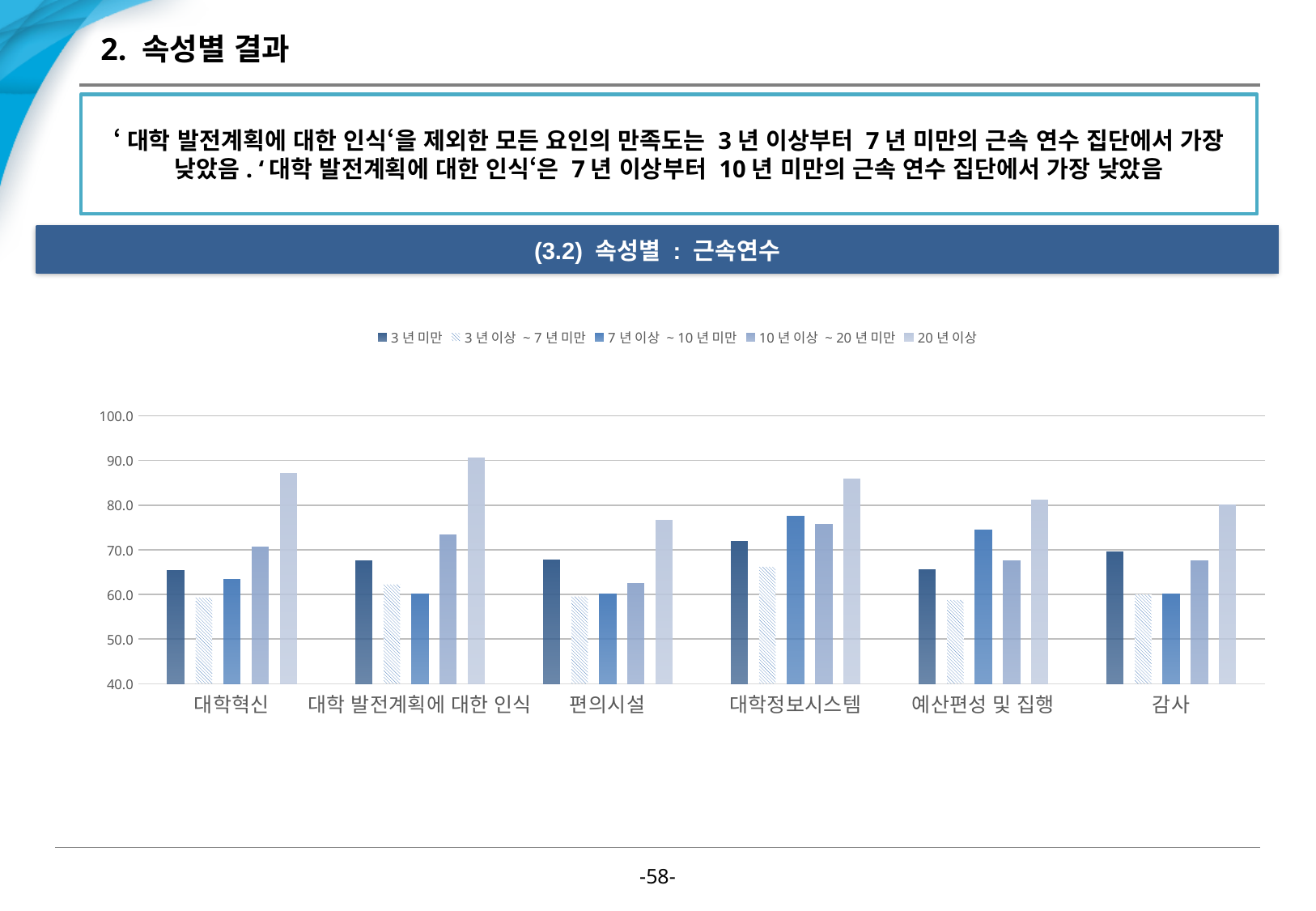
What kind of chart is shown on the slide? bar chart Is the value for 편의시설 in the 20년 이상 series greater or less than 80? less What is the lowest value shown on the chart's vertical axis? 40.0 For the 20년 이상 series, which category has the highest value? 대학 발전계획에 대한 인식 How many categories are shown on the x axis of the chart? 6 Is the value for 대학정보시스템 in the 20년 이상 series greater or less than 80? greater For 예산편성 및 집행, which is larger: the 7년 이상 ~ 10년 미만 value or the 10년 이상 ~ 20년 미만 value? 7년 이상 ~ 10년 미만 For the 20년 이상 series, which category has the lowest value? 편의시설 Which series has the highest value for 대학혁신? 20년 이상 Which series has the lowest value for 대학 발전계획에 대한 인식? 7년 이상 ~ 10년 미만 Which series has the lowest value for 예산편성 및 집행? 3년 이상 ~ 7년 미만 How many series does the chart legend list? 5